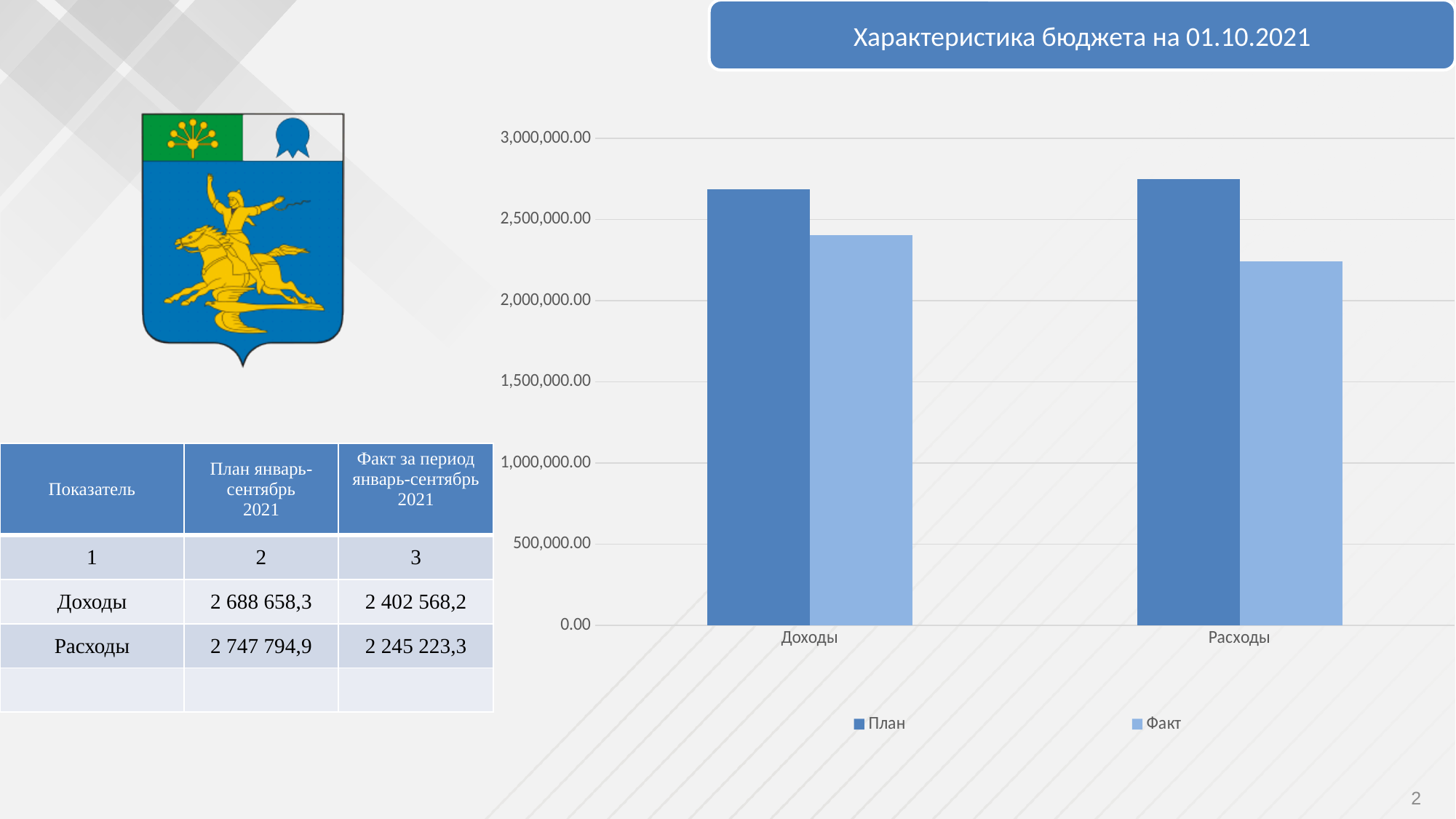
How many series does the chart legend list? 2 What kind of chart is shown on the slide? bar chart Is the План value for Доходы greater or less than 2,500,000.00? greater What is the title shown above the chart on the slide? Характеристика бюджета на 01.10.2021 Is the План value for Расходы greater or less than 2,500,000.00? greater Is the Факт value for Доходы greater or less than 2,500,000.00? less What are the two series named in the chart legend? План and Факт Which category has the larger Факт value, Доходы or Расходы? Доходы Which bar in the chart is the lowest? Факт for Расходы How many categories are shown on the x axis of the chart? 2 For Доходы, which is larger: the План bar or the Факт bar? План